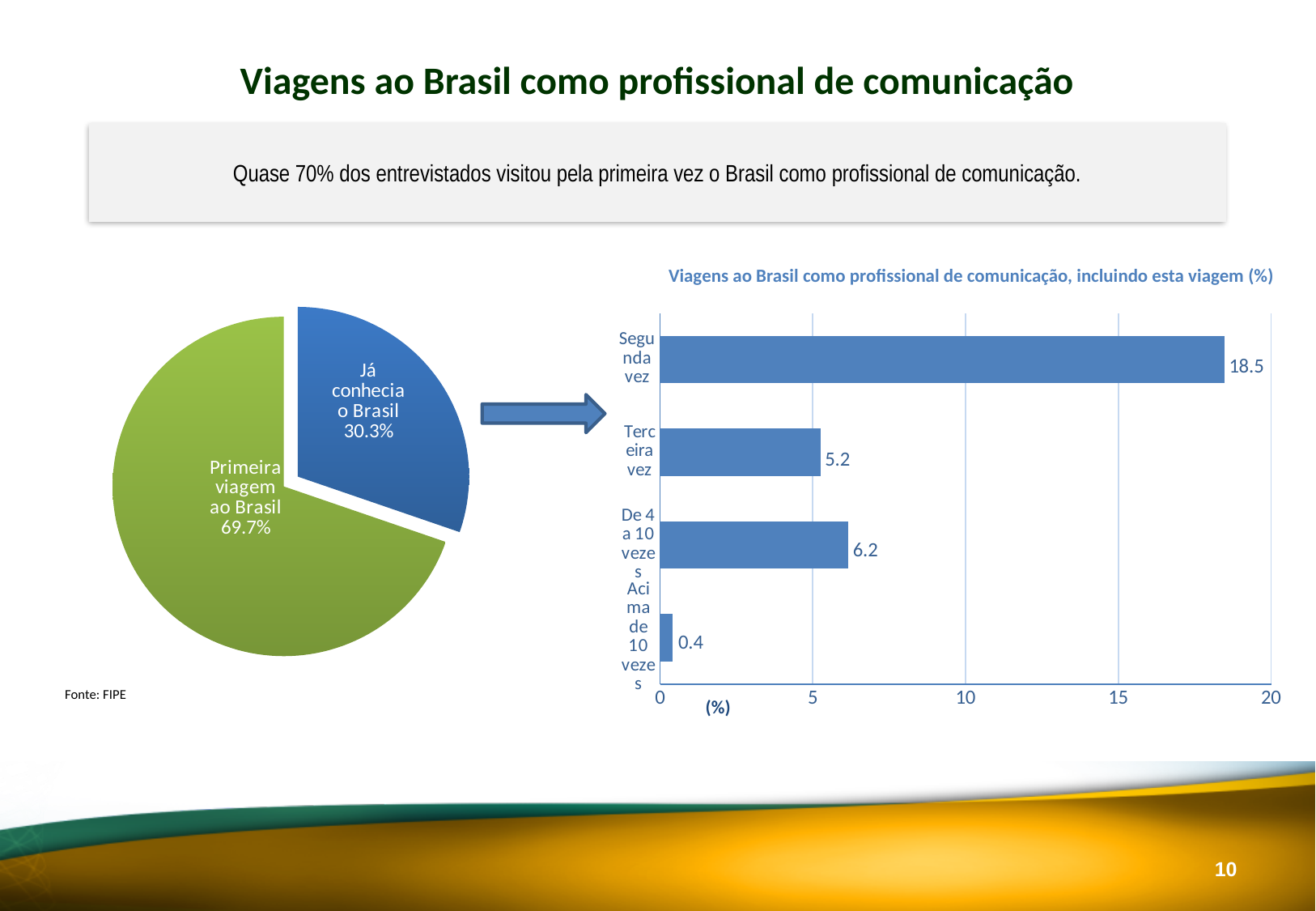
In the bar chart on the right, which is larger: the value for 'De 4 a 10 vezes' or the value for 'Terceira vez'? De 4 a 10 vezes What kind of chart is the chart on the right of the slide? Bar chart In the bar chart on the right, what is the value for 'Acima de 10 vezes'? 0.4 In the pie chart on the left, how many slices are there? 2 In the bar chart on the right, which category has the lowest value? Acima de 10 vezes In the bar chart on the right, what is the value for 'Segunda vez'? 18.5 In the bar chart on the right, how many categories are shown? 4 In the pie chart on the left, which slice is the largest? Primeira viagem ao Brasil In the pie chart on the left, what share is labelled for 'Já conhecia o Brasil'? 30.3% In the bar chart on the right, what is the difference between the values for 'Segunda vez' and 'Terceira vez'? 13.3 In the bar chart on the right, which category has the highest value? Segunda vez In the pie chart on the left, what share is labelled for 'Primeira viagem ao Brasil'? 69.7%